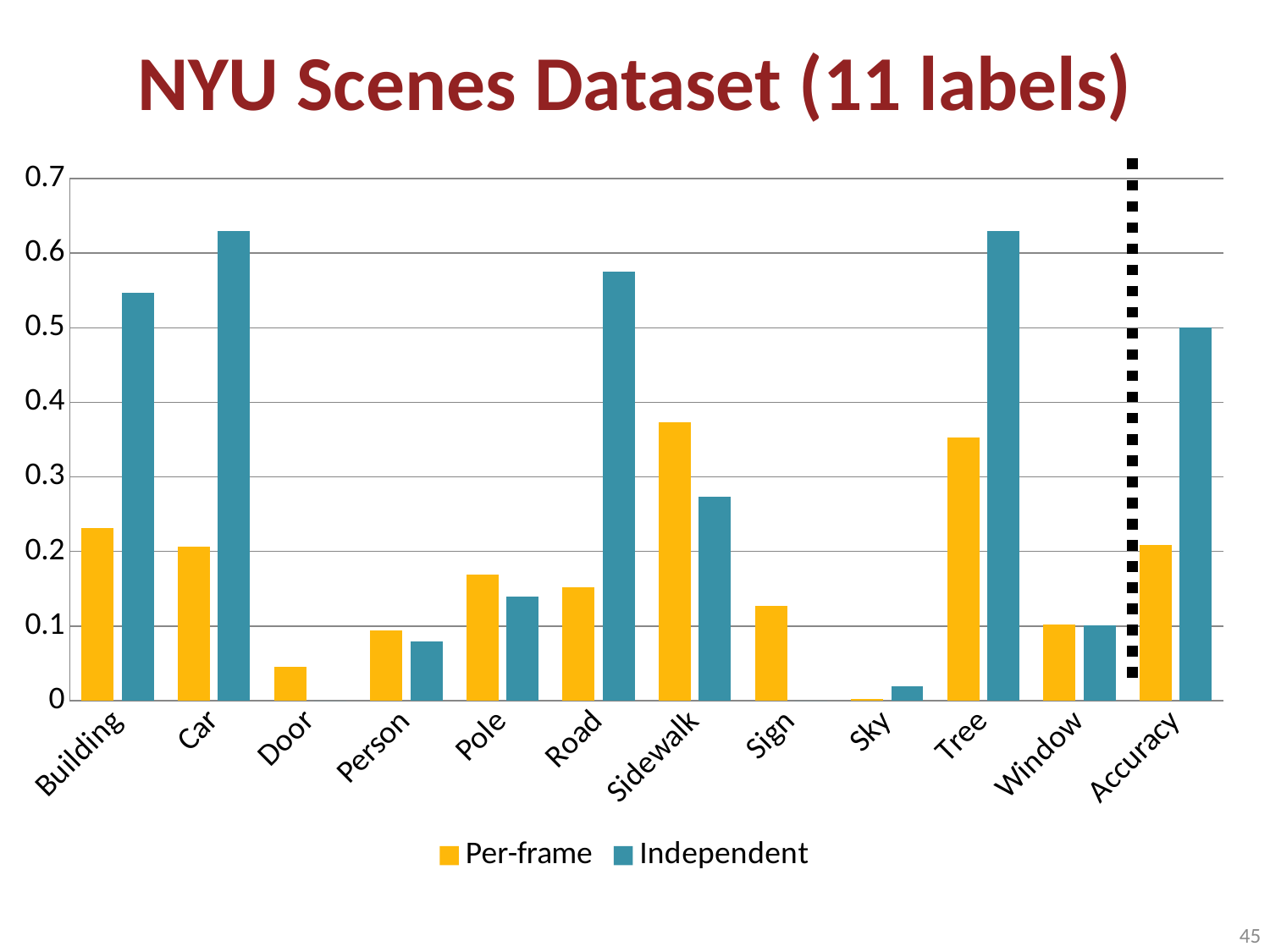
What is the title of the slide? NYU Scenes Dataset (11 labels) How many series does the legend list? 2 For Building, which is larger: the Per-frame value or the Independent value? Independent What kind of chart is shown on the slide? bar chart Which colour represents the Independent series in the legend? teal blue Is the Independent value for Road greater or less than 0.5? greater Which category has the lowest Per-frame value? Sky For Sidewalk, which is larger: the Per-frame value or the Independent value? Per-frame Is the Per-frame value for Sidewalk greater or less than 0.3? greater Is the Independent value for Tree greater or less than 0.6? greater How many categories are shown along the x axis? 12